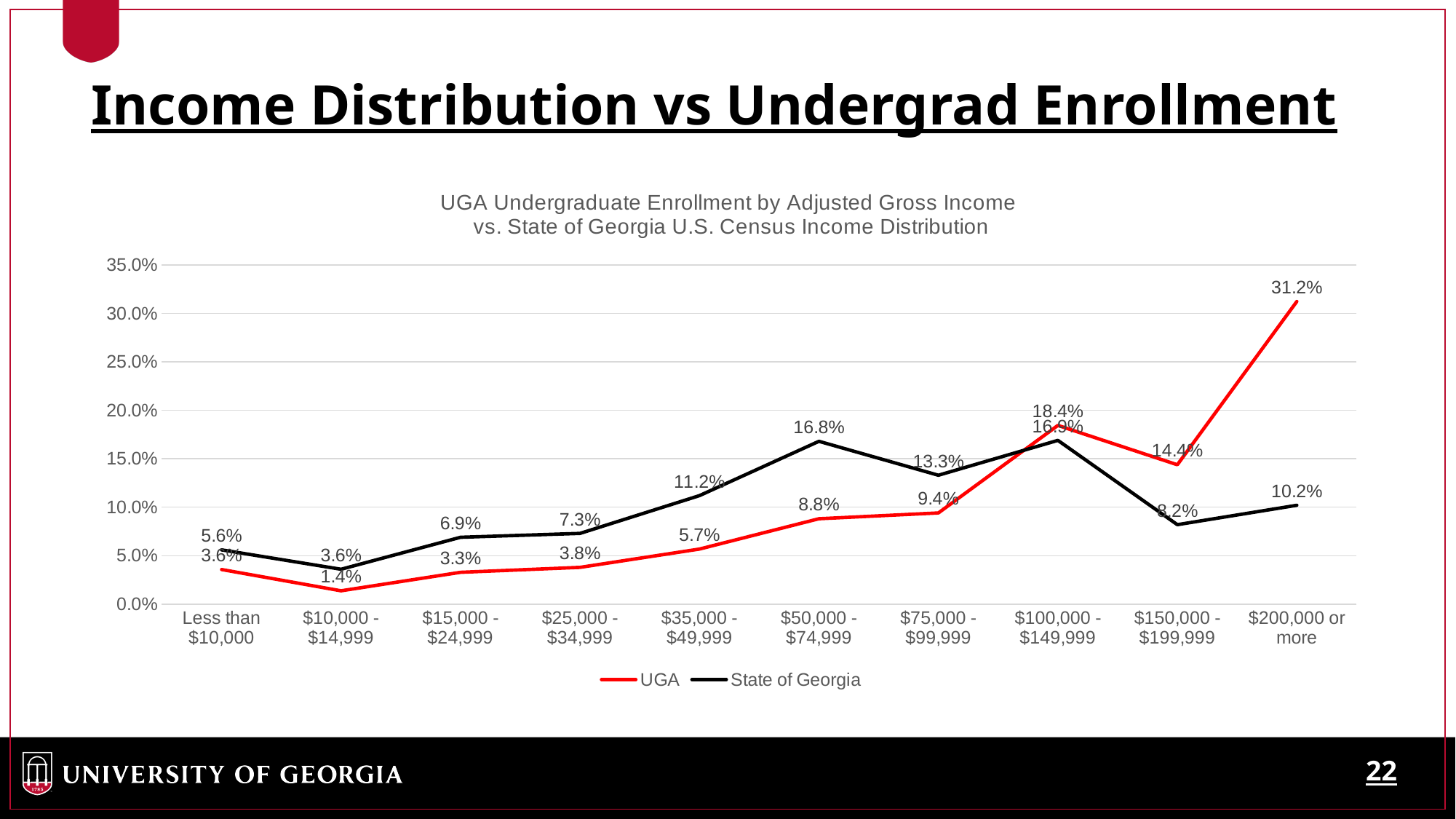
What is the difference between the UGA and State of Georgia values for the $200,000 or more category? 21.0% What is the State of Georgia value for the $50,000 - $74,999 category? 16.8% What type of chart is shown on the slide? Line chart Is the UGA value for the $100,000 - $149,999 category greater or less than 15.0%? greater What is the UGA value for the $10,000 - $14,999 category? 1.4% Which income category has the highest UGA value? $200,000 or more How many income categories are shown on the x axis? 10 What is the UGA value for the $200,000 or more category? 31.2% Which colour is used for the UGA line? Red For the $35,000 - $49,999 category, which series has the larger value, UGA or State of Georgia? State of Georgia How many series does the legend list? 2 Which income category has the lowest State of Georgia value? $10,000 - $14,999